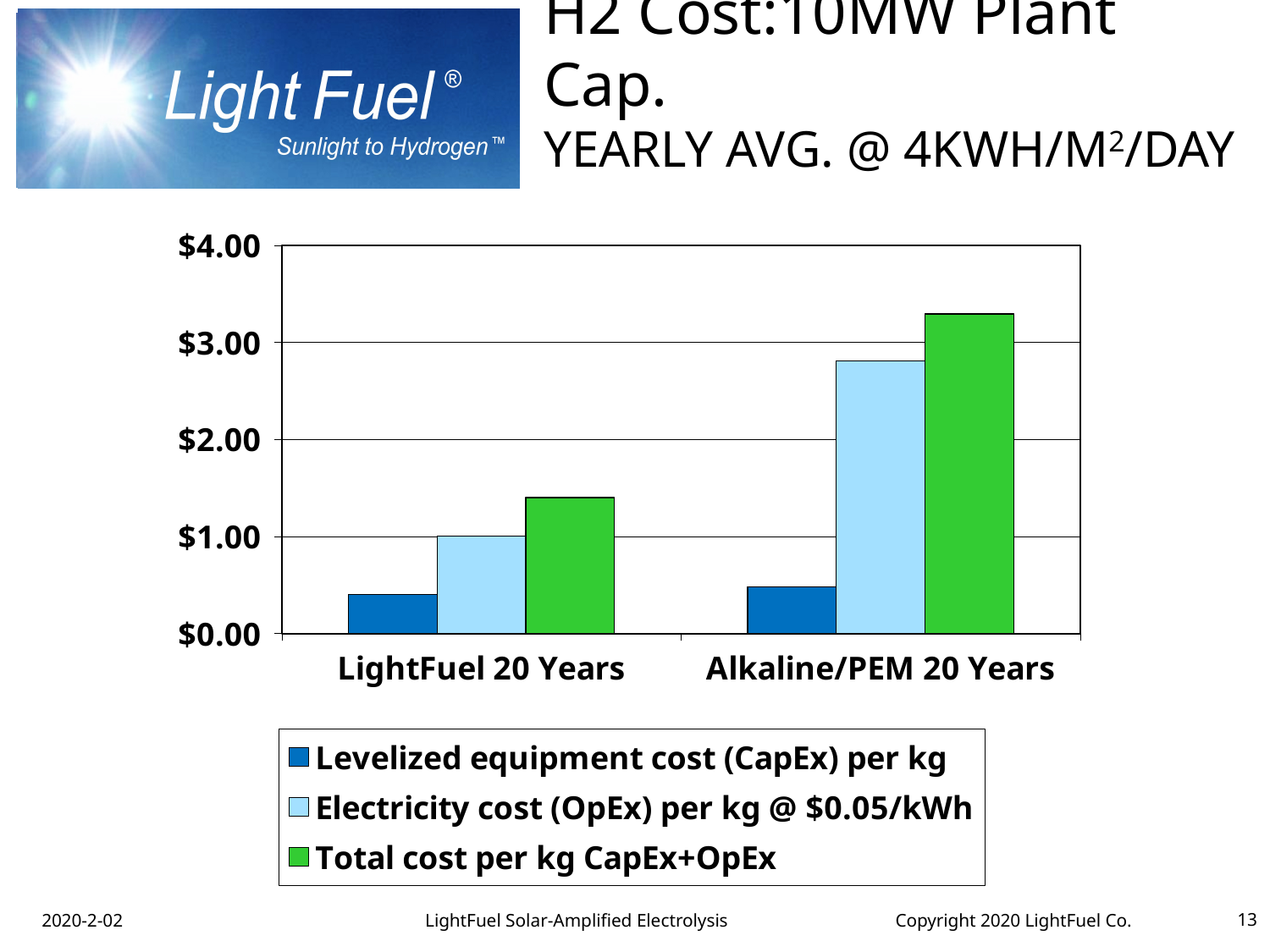
What electricity price is stated in the legend entry for the Electricity cost (OpEx) series? $0.05/kWh How many categories are shown on the x axis of the chart? 2 Which is larger: the Electricity cost (OpEx) per kg for LightFuel 20 Years or for Alkaline/PEM 20 Years? Alkaline/PEM 20 Years Which bar is the lowest in the whole chart? Levelized equipment cost (CapEx) per kg for LightFuel 20 Years How many series does the chart's legend list? 3 Which category has the highest Total cost per kg CapEx+OpEx bar? Alkaline/PEM 20 Years What kind of chart is shown on the slide? bar chart Is the Electricity cost (OpEx) per kg for Alkaline/PEM 20 Years greater or less than $2.00? greater Is the Total cost per kg CapEx+OpEx for LightFuel 20 Years greater or less than $2.00? less Is the Levelized equipment cost (CapEx) per kg for LightFuel 20 Years greater or less than $1.00? less Which series is shown in green in the chart? Total cost per kg CapEx+OpEx